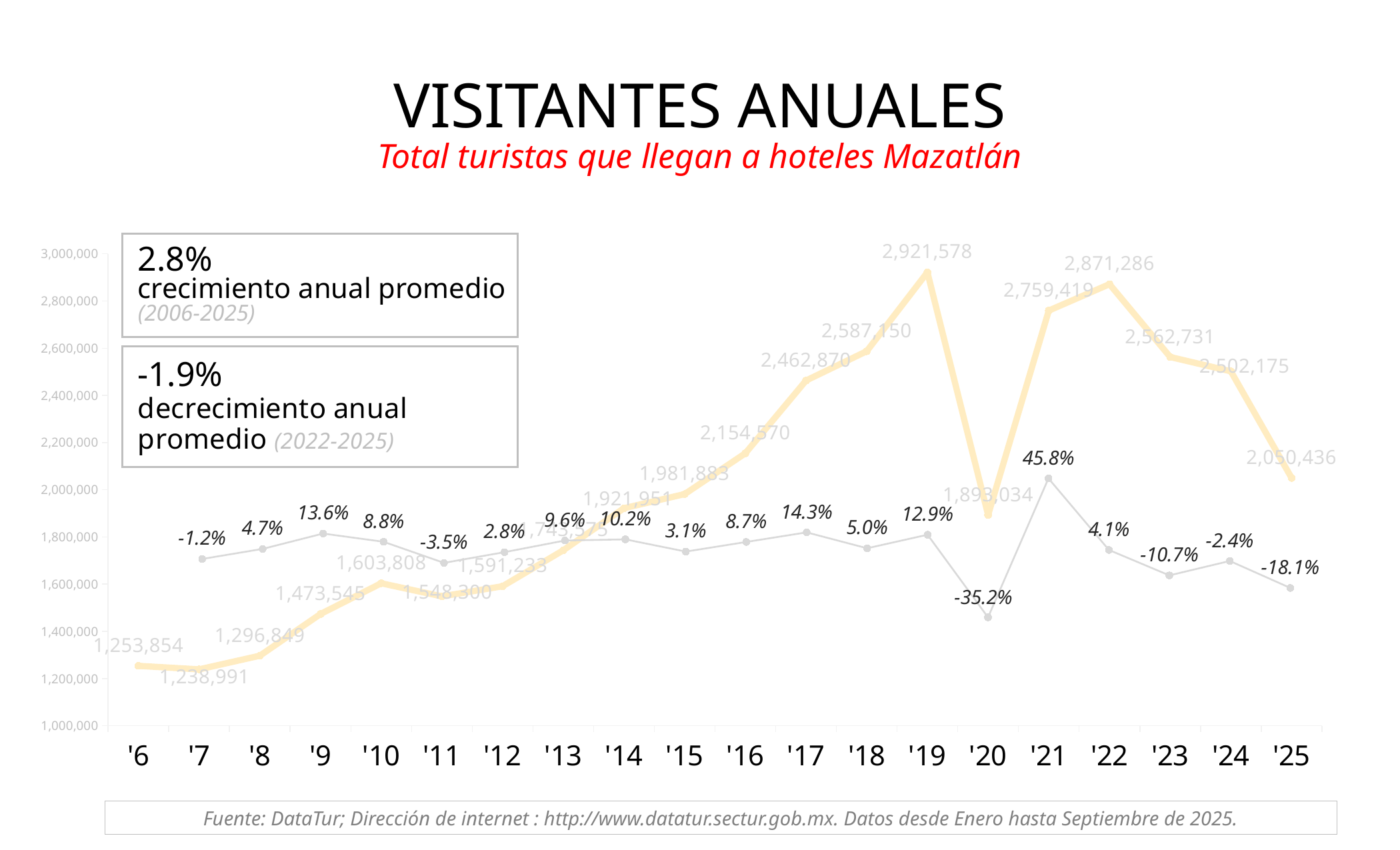
What type of chart is shown on the slide? line chart Which year has the lowest percentage change? '20 Which year has the highest number of visitors? '19 What is the difference in visitors between '22 and '23? 308,555 What percentage change is shown for '21? 45.8% What is the number of visitors shown for '19? 2,921,578 What is the number of visitors shown for '25? 2,050,436 Is the number of visitors for '16 greater or less than 2,000,000? greater How many years are shown on the x axis? 20 Which year has more visitors, '17 or '24? '24 What percentage change is shown for '23? -10.7% What is the average annual growth rate stated for 2006-2025? 2.8%